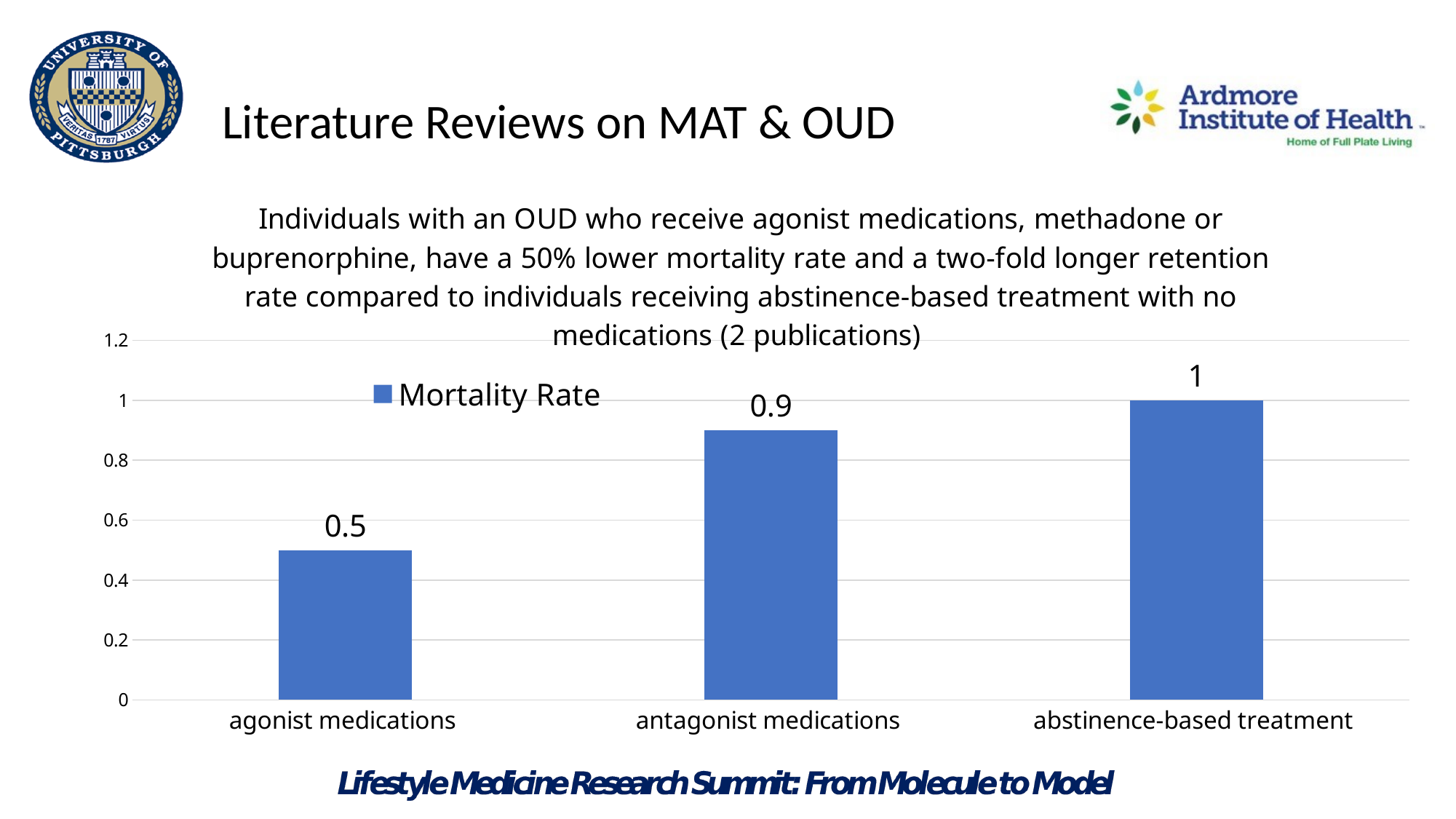
What series name is listed in the chart legend? Mortality Rate Which category has the lowest Mortality Rate? agonist medications What is the difference in Mortality Rate between antagonist medications and agonist medications? 0.4 What kind of chart is shown on the slide? bar chart Is the Mortality Rate for antagonist medications greater or less than 0.8? greater Which has a higher Mortality Rate, agonist medications or antagonist medications? antagonist medications What is the Mortality Rate value for antagonist medications? 0.9 Which category has the highest Mortality Rate? abstinence-based treatment What is the difference in Mortality Rate between abstinence-based treatment and agonist medications? 0.5 How many categories are shown on the x axis of the chart? 3 What is the Mortality Rate value for abstinence-based treatment? 1 What is the Mortality Rate value for agonist medications? 0.5